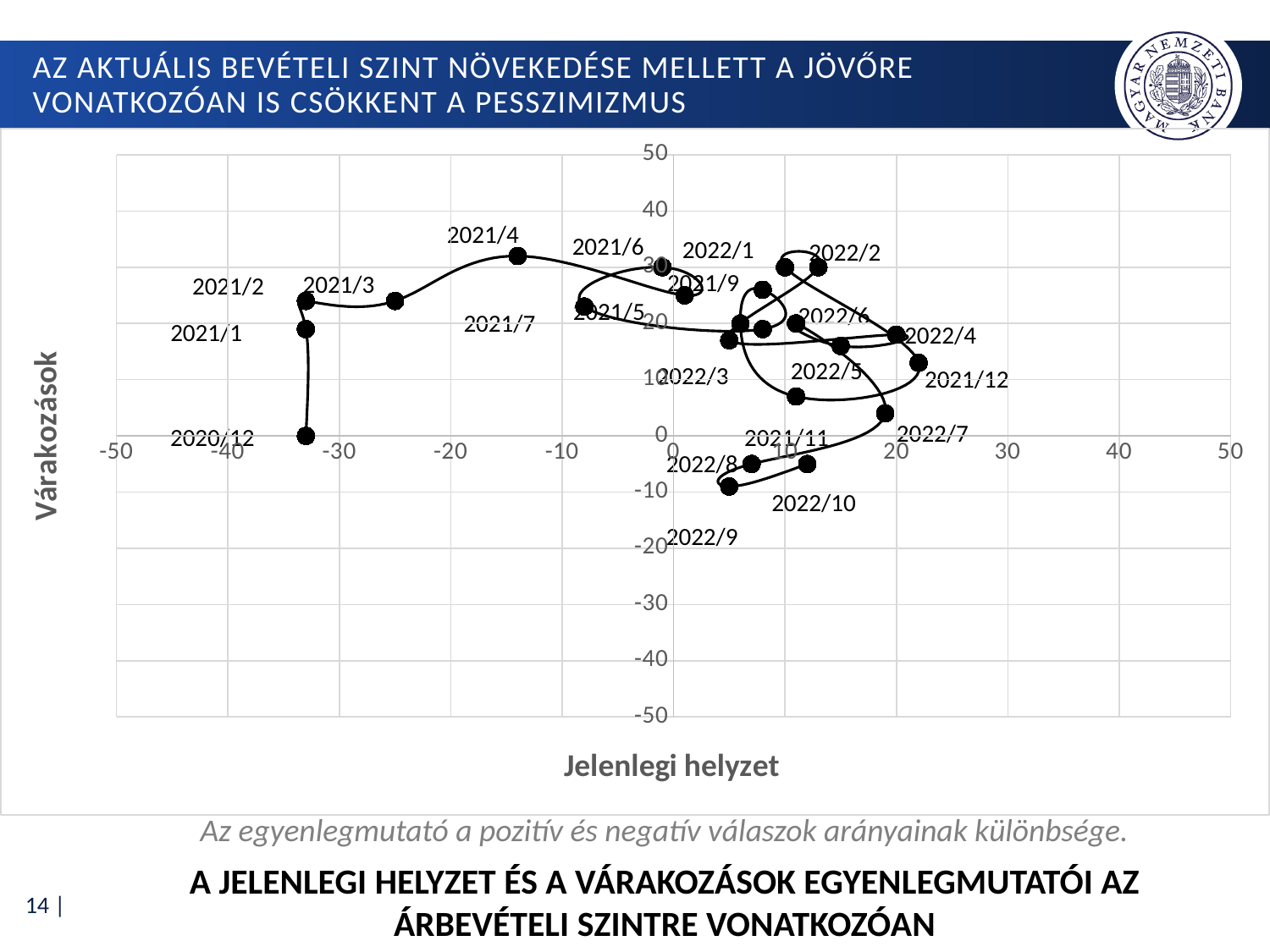
Which has the higher Várakozások value, 2021/4 or 2021/7? 2021/4 What is the title of the vertical axis of the chart? Várakozások Is the Jelenlegi helyzet value for 2021/12 greater or less than 10? greater Is the Jelenlegi helyzet value for 2021/4 greater or less than 0? less What kind of chart is shown on the slide? scatter chart with smoothed lines Which point has the lowest Várakozások value? 2022/9 Is the Várakozások value for 2021/4 greater or less than 20? greater Which has the higher Várakozások value, 2022/7 or 2022/9? 2022/7 What is the title of the horizontal axis of the chart? Jelenlegi helyzet